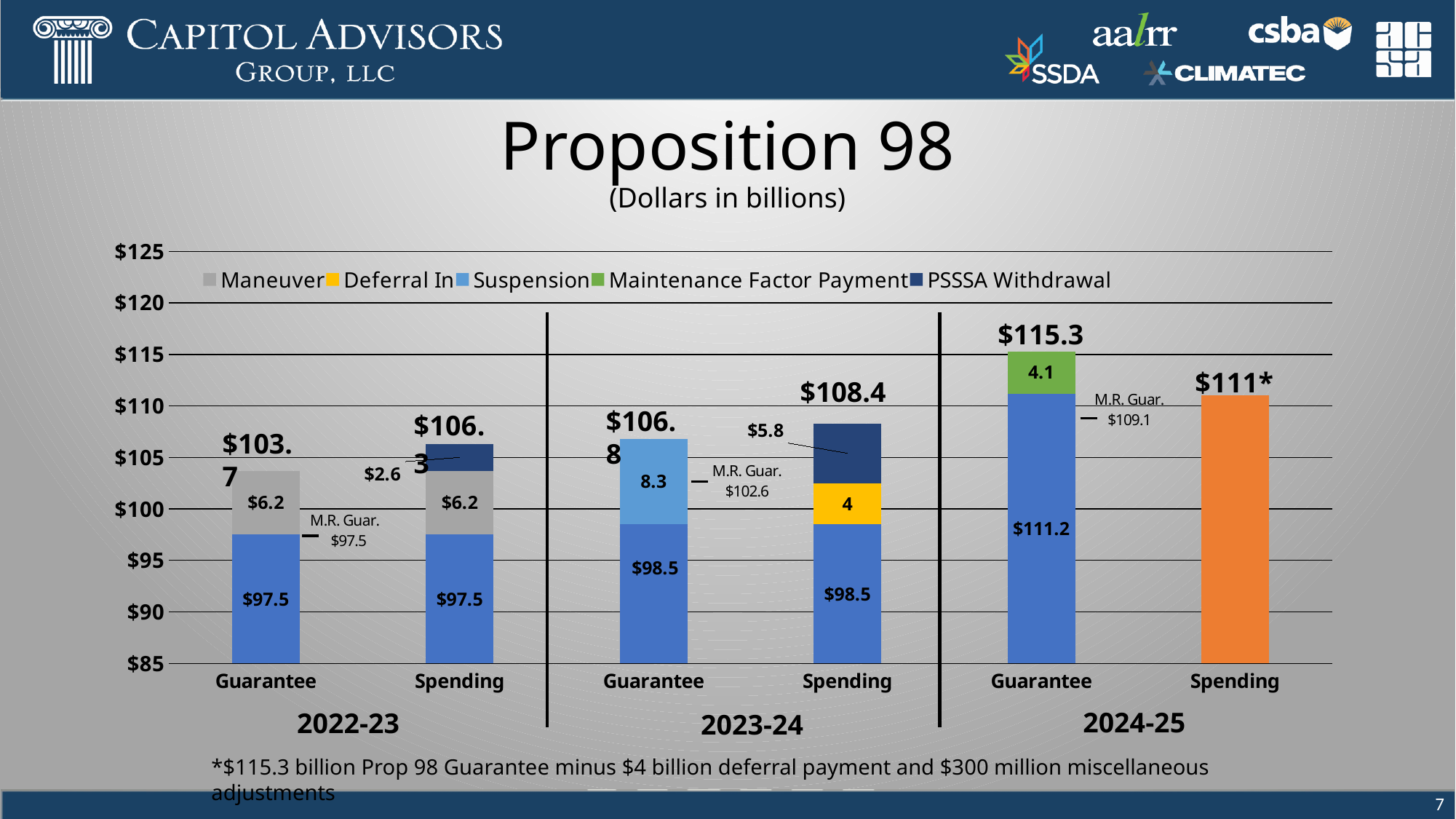
Which bar has the lowest total value? 2022-23 Guarantee How many bars are plotted on the chart? 6 What is the difference between the 2023-24 Spending total and the 2023-24 Guarantee total? $1.6 How many series does the legend list? 5 Which bar has the highest total value? 2024-25 Guarantee What is the value of the PSSSA Withdrawal segment in the 2023-24 Spending bar? $5.8 Do the Guarantee totals rise or fall from 2022-23 to 2024-25? rise What is the value of the Maneuver segment in the 2022-23 Guarantee bar? $6.2 What is the M.R. Guar. value shown for 2023-24? $102.6 Which is larger in 2022-23, the Guarantee total or the Spending total? Spending What is the value of the Suspension segment in the 2023-24 Guarantee bar? 8.3 What is the total value labeled on the 2024-25 Guarantee bar? $115.3